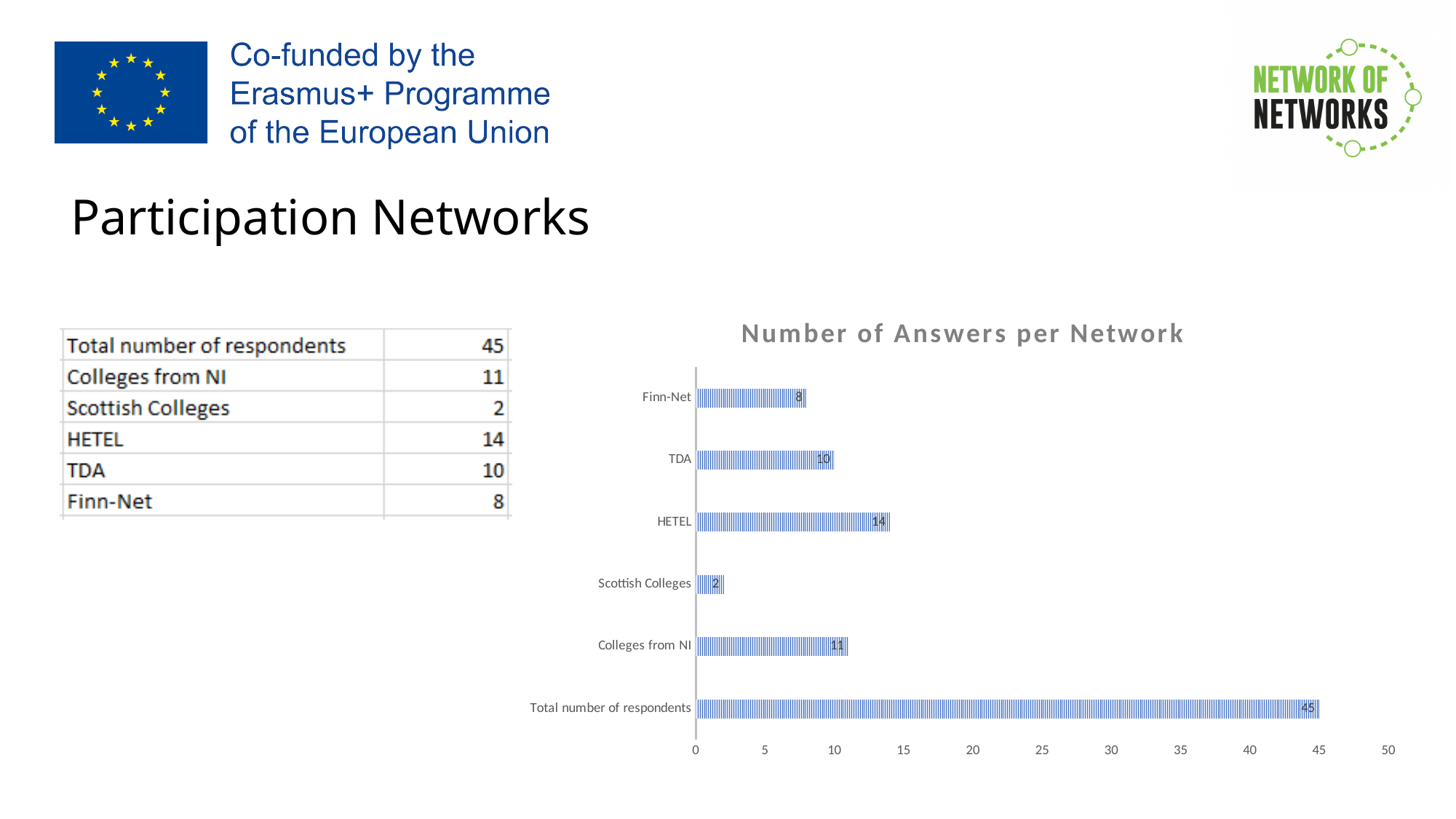
Excluding the Total number of respondents bar, which network has the highest value? HETEL Which category has the lowest value in the chart? Scottish Colleges Is the value for TDA greater or less than 15? less Which has a larger value, Colleges from NI or Finn-Net? Colleges from NI What is the title of the chart? Number of Answers per Network What type of chart is shown on the slide? bar chart What is the value for HETEL in the chart? 14 What is the value for Total number of respondents in the chart? 45 How many categories are plotted in the chart? 6 What is the value for Finn-Net in the chart? 8 What is the value for Scottish Colleges in the chart? 2 What is the difference between the values for HETEL and TDA? 4